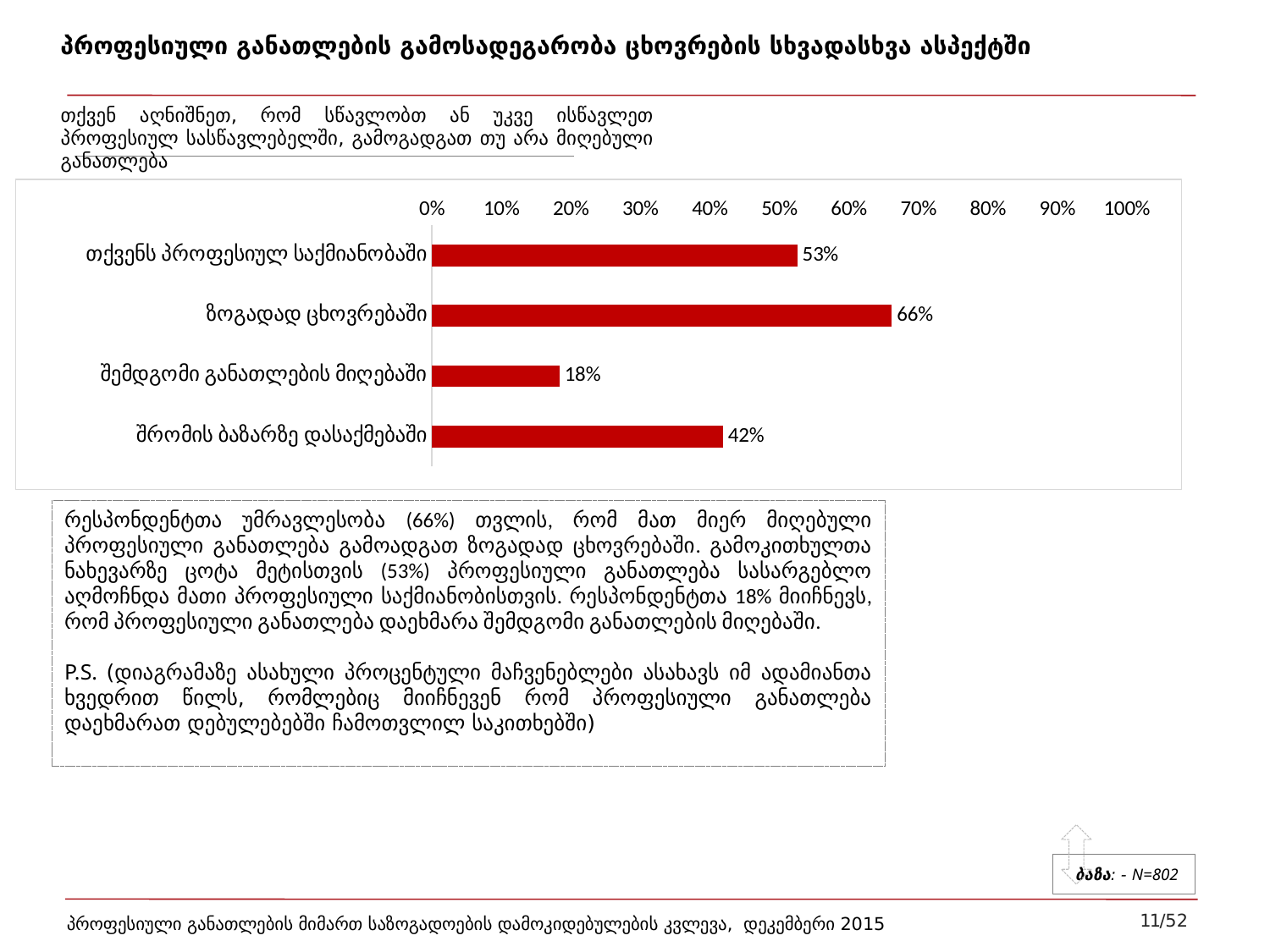
Is the value for "ზოგადად ცხოვრებაში" greater or less than 60%? greater What is the difference between the values for "ზოგადად ცხოვრებაში" and "თქვენს პროფესიულ საქმიანობაში"? 13% Which category has the lowest value? შემდგომი განათლების მიღებაში Which category has the highest value? ზოგადად ცხოვრებაში What is the value for "შრომის ბაზარზე დასაქმებაში"? 42% What is the difference between the values for "შრომის ბაზარზე დასაქმებაში" and "შემდგომი განათლების მიღებაში"? 24% Which is larger: the value for "თქვენს პროფესიულ საქმიანობაში" or for "შრომის ბაზარზე დასაქმებაში"? თქვენს პროფესიულ საქმიანობაში What kind of chart is shown on the slide? bar chart What is the value for "შემდგომი განათლების მიღებაში"? 18% How many categories are shown in the chart? 4 What is the value for "ზოგადად ცხოვრებაში"? 66% What is the value for "თქვენს პროფესიულ საქმიანობაში"? 53%